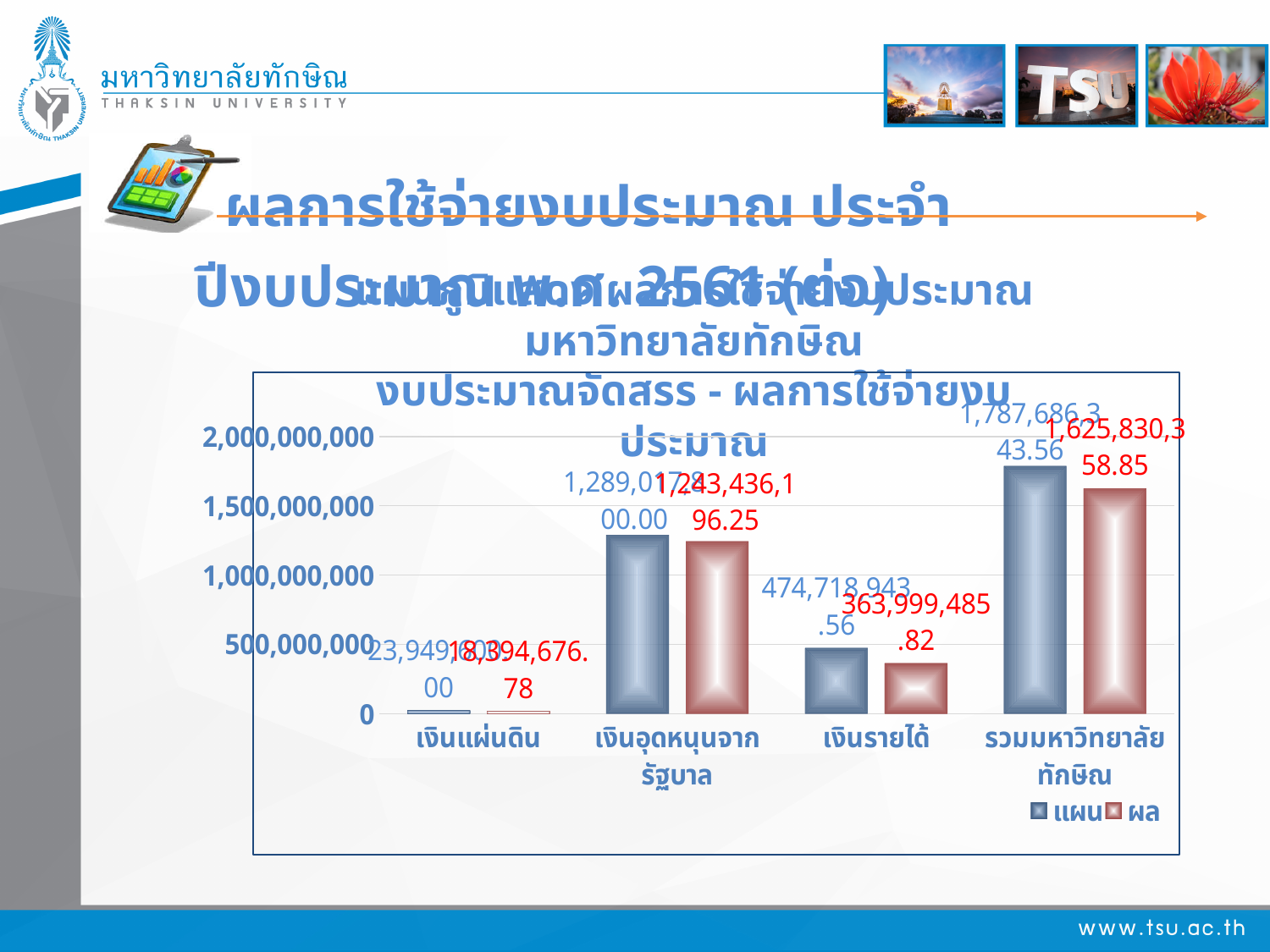
For เงินรายได้, which is larger, แผน or ผล? แผน What is the difference between the แผน and ผล values for เงินรายได้? 110,719,457.74 Is the แผน value for รวมมหาวิทยาลัยทักษิณ greater or less than 1,500,000,000? greater Which category has the lowest ผล value? เงินแผ่นดิน How many categories are shown on the x axis of the chart? 4 What is the ผล value for เงินรายได้? 363,999,485.82 What is the แผน value for เงินรายได้? 474,718,943.56 Is the ผล value for เงินอุดหนุนจากรัฐบาล greater or less than 1,000,000,000? greater What are the two series named in the legend? แผน and ผล How many series does the chart legend list? 2 What kind of chart is shown on the slide? bar chart Which category has the highest แผน value? รวมมหาวิทยาลัยทักษิณ